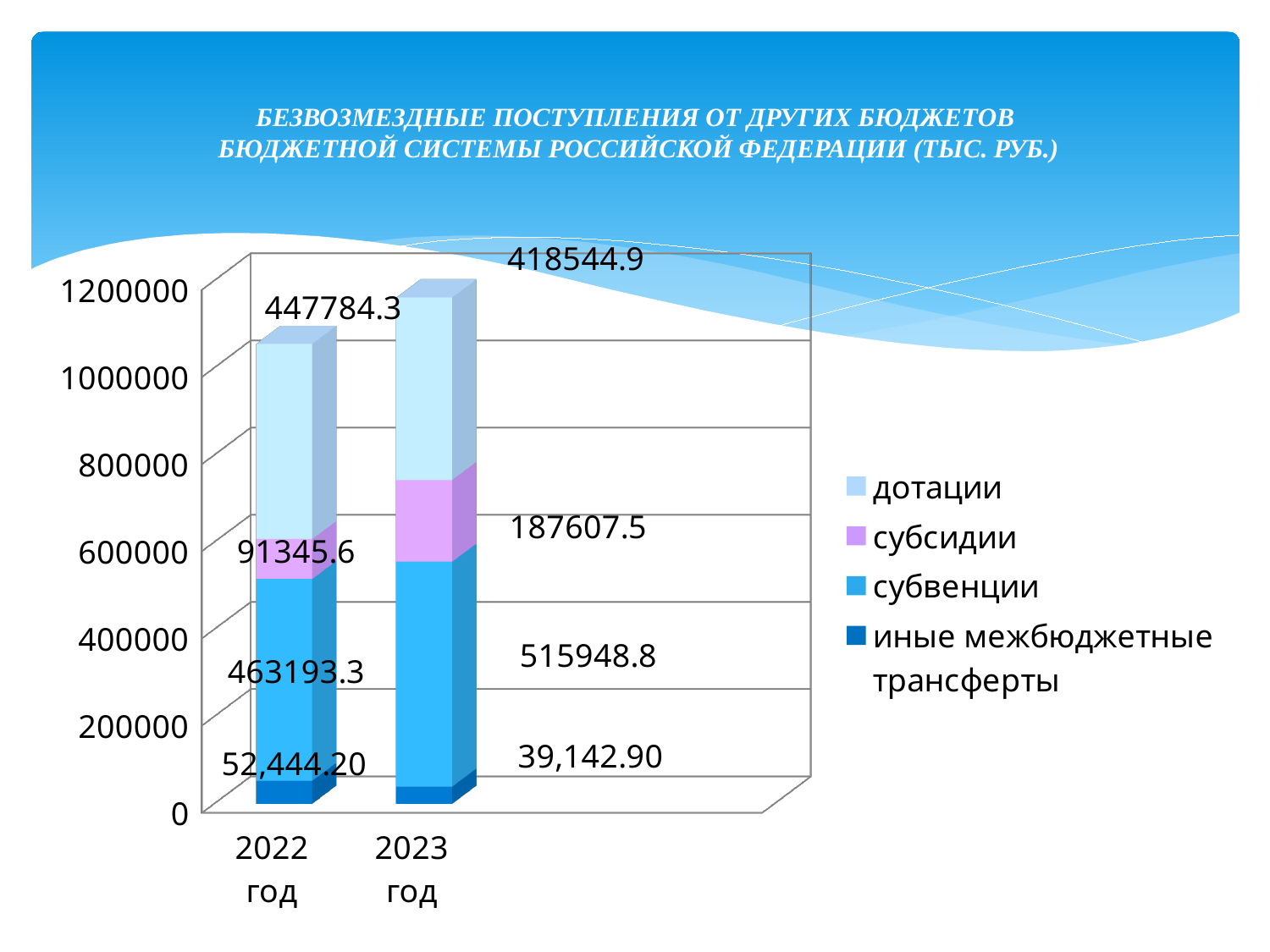
What is the total of the stacked bar for 2023 год? 1161244.1 What type of chart is shown on the slide? Stacked bar chart How many series does the legend list? 4 What is the value of дотации for 2022 год? 447784.3 How many categories (years) are shown on the x axis? 2 What is the value of субсидии for 2022 год? 91345.6 Which series is shown in the lightest blue colour in the legend? дотации What is the value of иные межбюджетные трансферты for 2023 год? 39,142.90 What is the difference between дотации in 2022 год and 2023 год? 29239.4 Which year has the larger value for субсидии, 2022 год or 2023 год? 2023 год By how much did субсидии increase from 2022 год to 2023 год? 96261.9 What is the value of субвенции for 2023 год? 515948.8